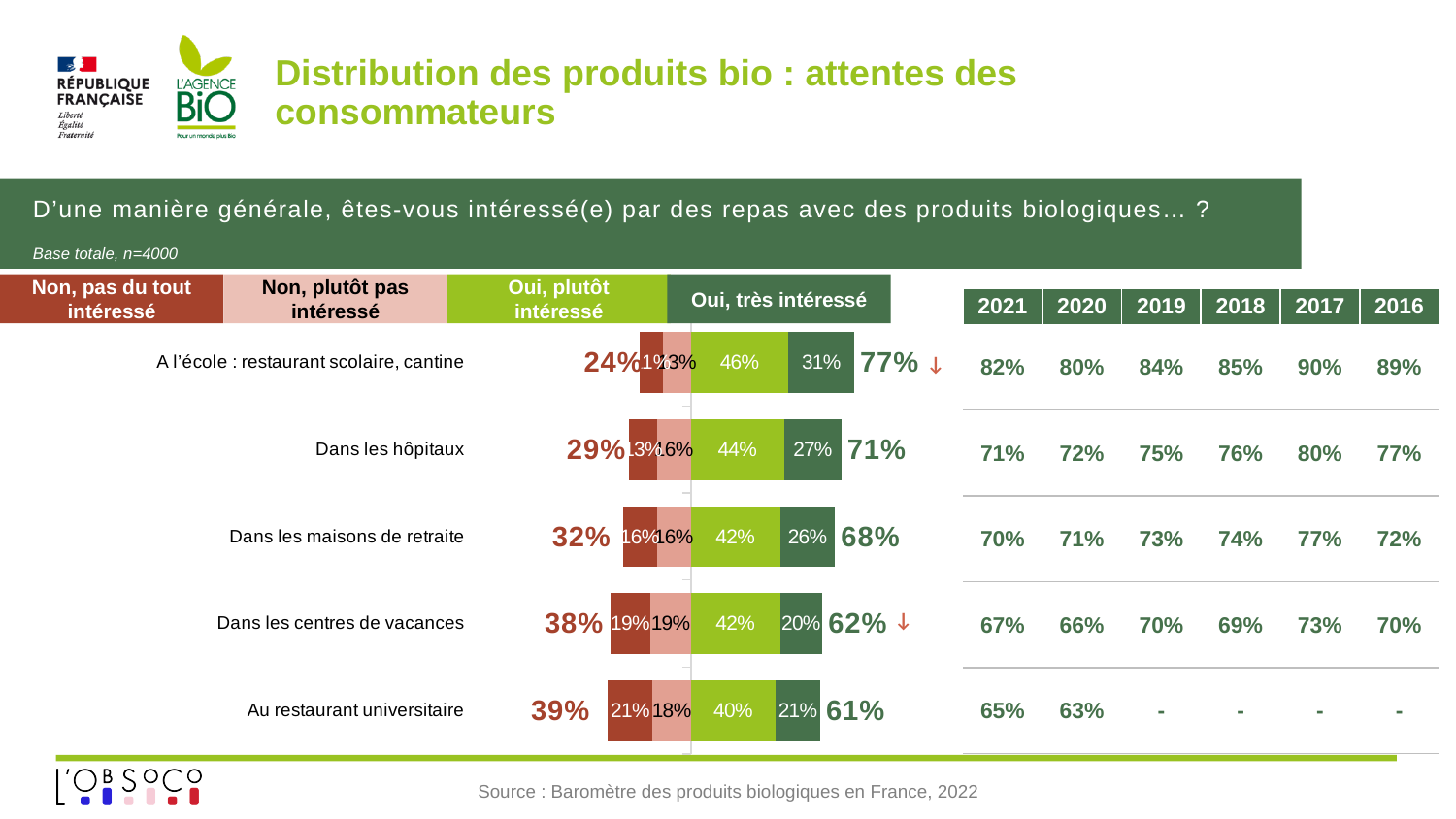
Which category has the lowest value for "Oui, plutôt intéressé"? Au restaurant universitaire Which is larger: the "Oui, plutôt intéressé" value for "Dans les maisons de retraite" or for "Au restaurant universitaire"? Dans les maisons de retraite How many categories (places) are plotted in the bar chart? 5 What kind of chart is shown on the slide? bar chart Which category has the highest value for "Oui, très intéressé"? A l'école : restaurant scolaire, cantine How many series does the legend of the bar chart list? 4 What is the value of "Oui, très intéressé" for "A l'école : restaurant scolaire, cantine"? 31% What is the value of "Oui, plutôt intéressé" for "Dans les hôpitaux"? 44% What is the total of the two "Oui" segments (plutôt + très intéressé) for "Dans les centres de vacances"? 62% What is the value of "Non, plutôt pas intéressé" for "Dans les centres de vacances"? 19% What is the difference between the "Oui, très intéressé" values for "Dans les hôpitaux" and "Dans les maisons de retraite"? 1% What is the value of "Non, pas du tout intéressé" for "Au restaurant universitaire"? 21%